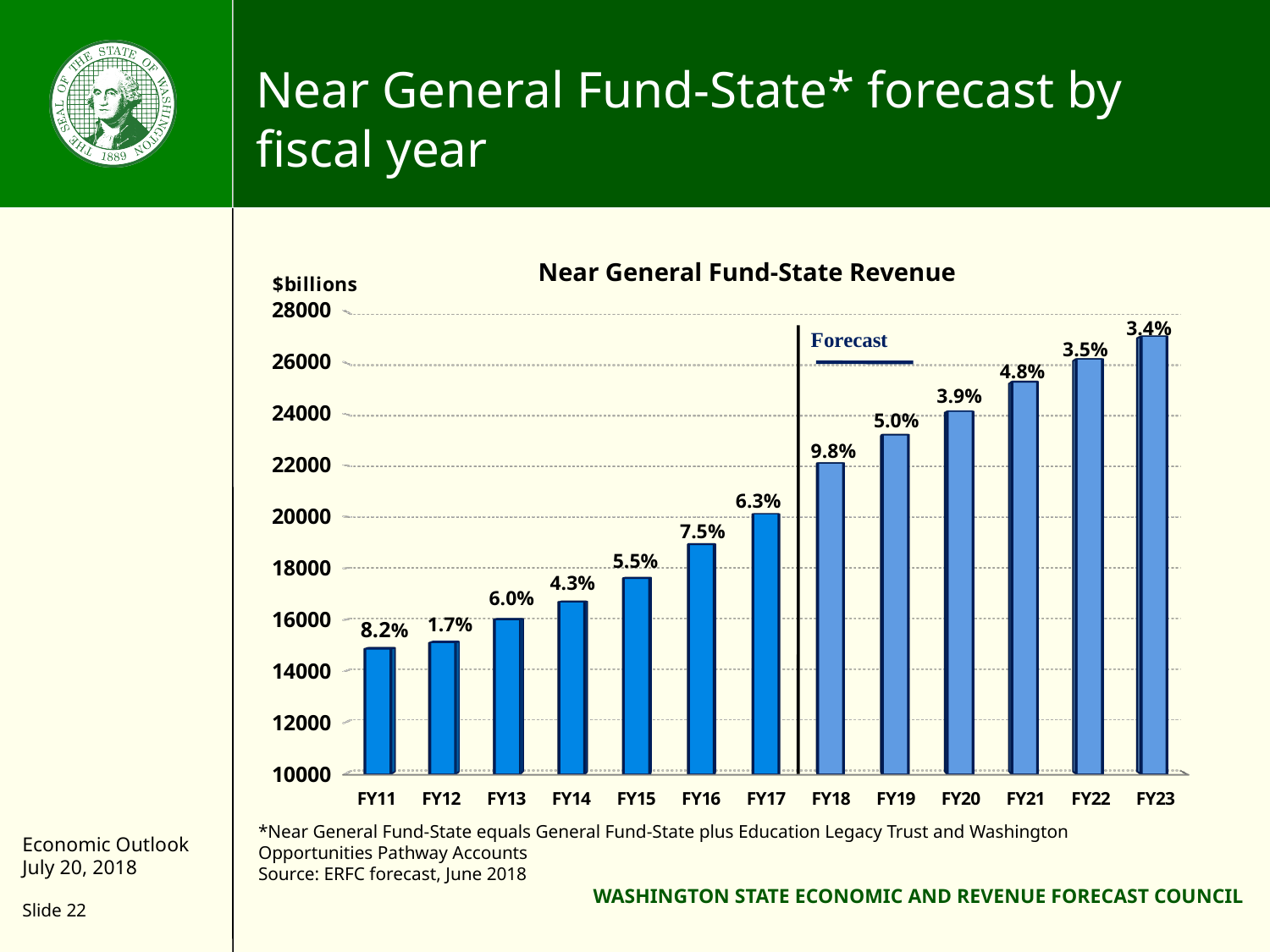
Do the revenue bars rise or fall from FY11 to FY23? rise Which has the larger growth rate label, FY16 or FY17? FY16 What is the growth rate label shown above the FY23 bar? 3.4% Which fiscal year has the lowest growth rate label? FY12 How many fiscal years are shown on the x axis? 13 Is the revenue bar for FY23 greater or less than 26000? greater What is the growth rate label shown above the FY18 bar? 9.8% Is the revenue bar for FY11 greater or less than 16000? less What is the growth rate label shown above the FY12 bar? 1.7% Which fiscal year has the highest growth rate label? FY18 What kind of chart is shown on the slide? bar chart What is the difference between the growth rate labels for FY18 and FY12? 8.1 percentage points